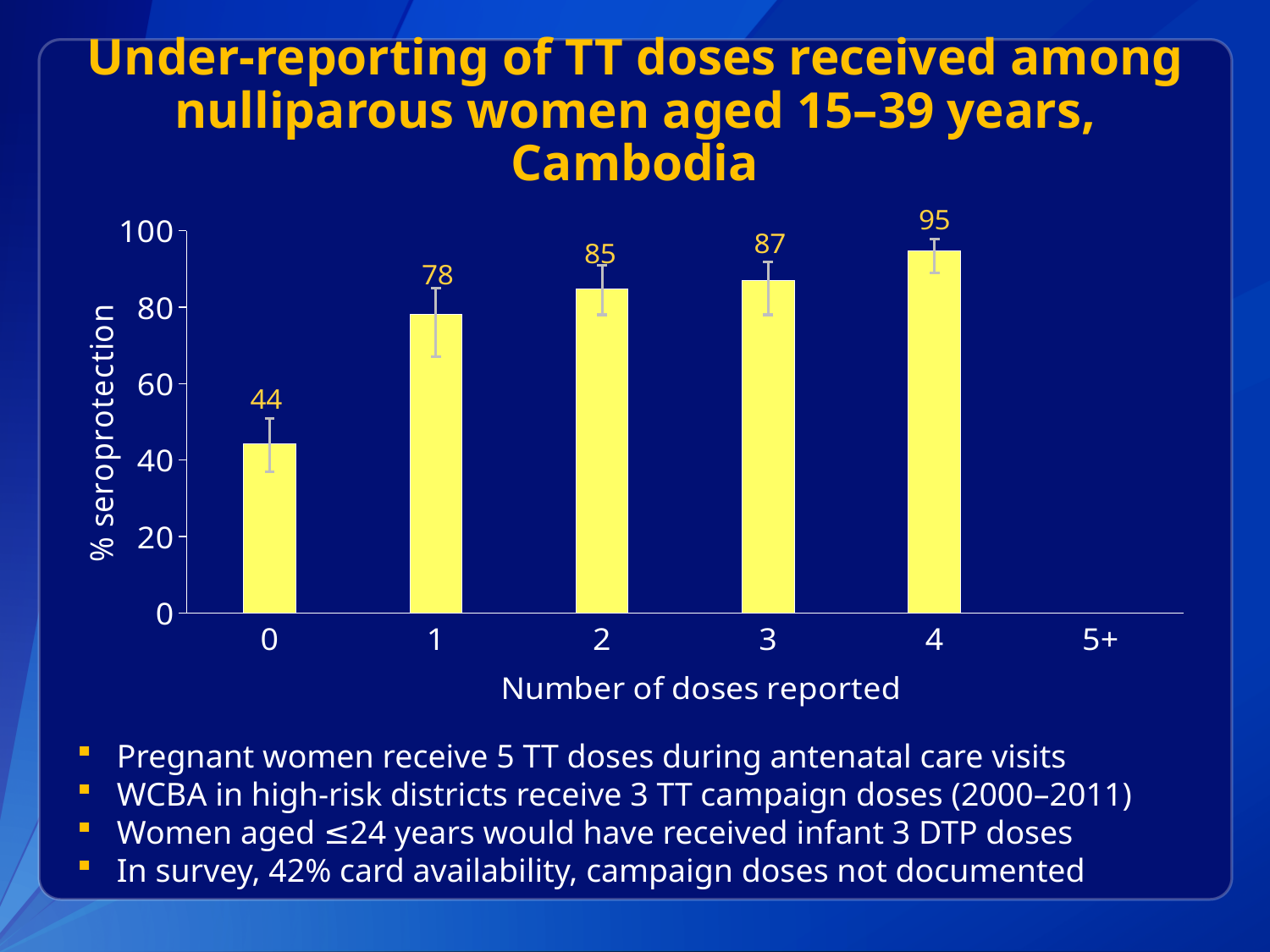
What is the % seroprotection for women reporting 3 doses? 87 What is the difference in % seroprotection between 2 doses and 1 dose reported? 7 What is the % seroprotection for women reporting 1 dose? 78 Does % seroprotection rise or fall as the number of doses reported increases from 0 to 4? rise What kind of chart is shown on the slide? bar chart Which number of doses reported has the highest % seroprotection? 4 What is the difference in % seroprotection between 4 doses and 0 doses reported? 51 Which has a higher % seroprotection: 1 dose reported or 3 doses reported? 3 doses reported How many bars are plotted in the chart? 5 Which number of doses reported has the lowest % seroprotection? 0 Is the % seroprotection for 0 doses reported greater or less than 60? less What is the % seroprotection for women reporting 0 doses? 44